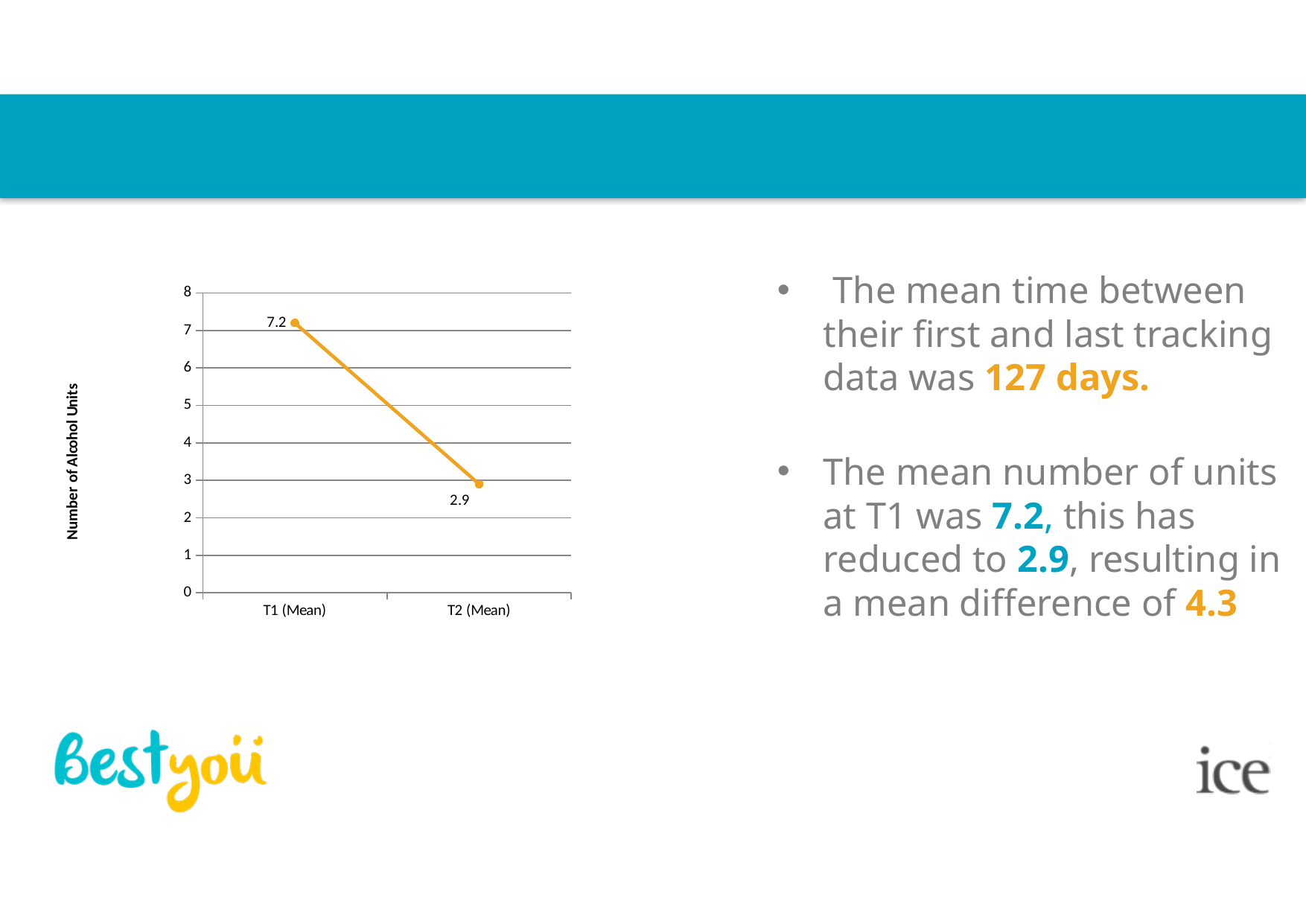
How many categories are plotted on the x axis? 2 Is the value for T2 (Mean) greater or less than 4? less Which category has the highest value? T1 (Mean) Do the values rise or fall from T1 (Mean) to T2 (Mean)? fall What is the difference between the values for T1 (Mean) and T2 (Mean)? 4.3 What is the label of the vertical axis? Number of Alcohol Units What is the value for T1 (Mean)? 7.2 Which is larger, the value for T1 (Mean) or T2 (Mean)? T1 (Mean) What is the value for T2 (Mean)? 2.9 Which category has the lowest value? T2 (Mean) Is the value for T1 (Mean) greater or less than 5? greater What kind of chart is shown on the slide? line chart